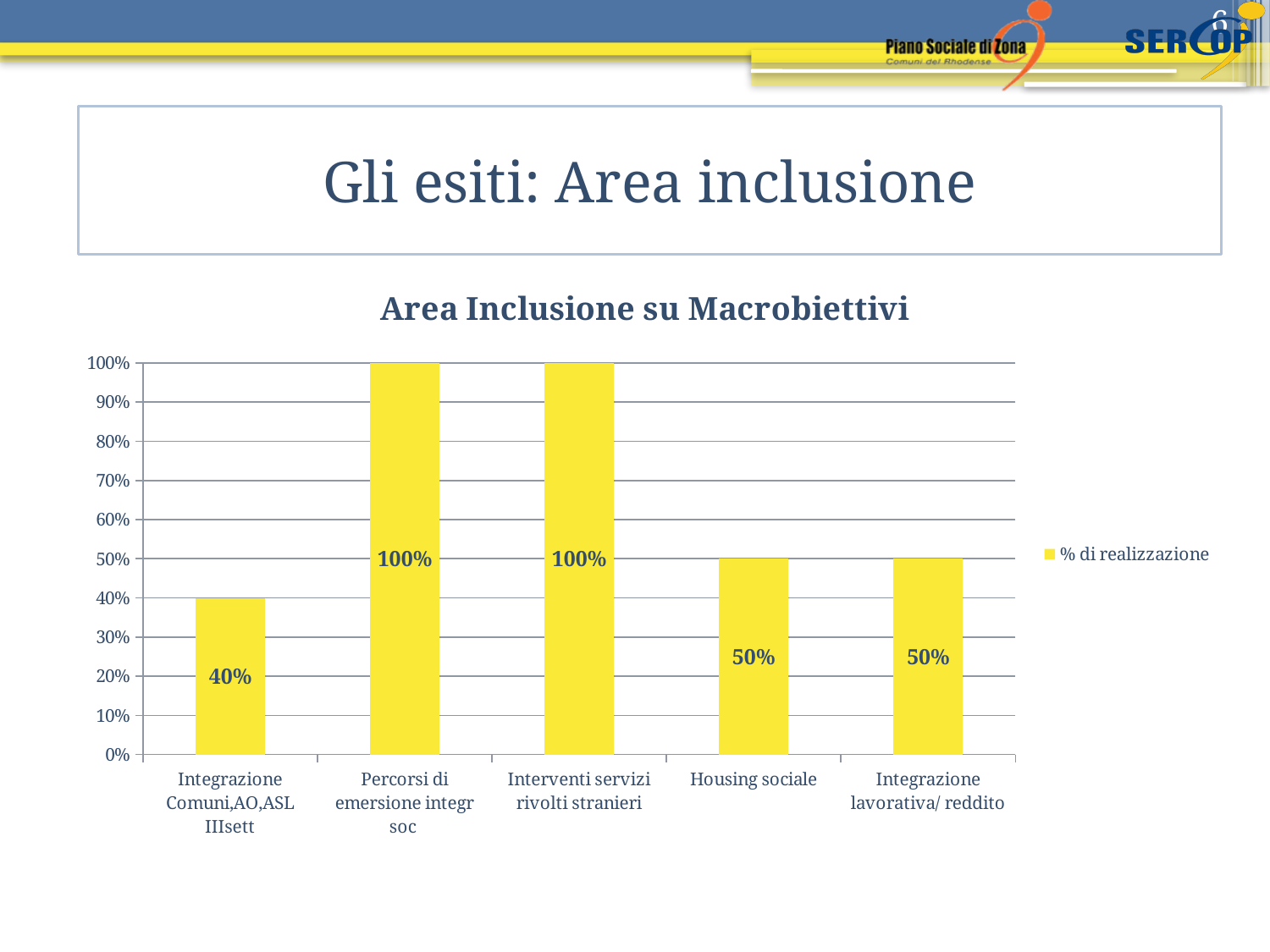
How many series does the legend list? 1 What is the difference between the values for Housing sociale and Integrazione Comuni,AO,ASL IIIsett? 10% What kind of chart is shown? Bar chart Which is larger, the value for Percorsi di emersione integr soc or the value for Integrazione lavorativa/ reddito? Percorsi di emersione integr soc What is the value for Integrazione lavorativa/ reddito? 50% How many categories are shown on the x axis? 5 What is the difference between the values for Interventi servizi rivolti stranieri and Housing sociale? 50% What is the title of the chart? Area Inclusione su Macrobiettivi What is the value for Housing sociale? 50% What is the value for Integrazione Comuni,AO,ASL IIIsett? 40% What is the value for Percorsi di emersione integr soc? 100% Which category has the lowest value? Integrazione Comuni,AO,ASL IIIsett